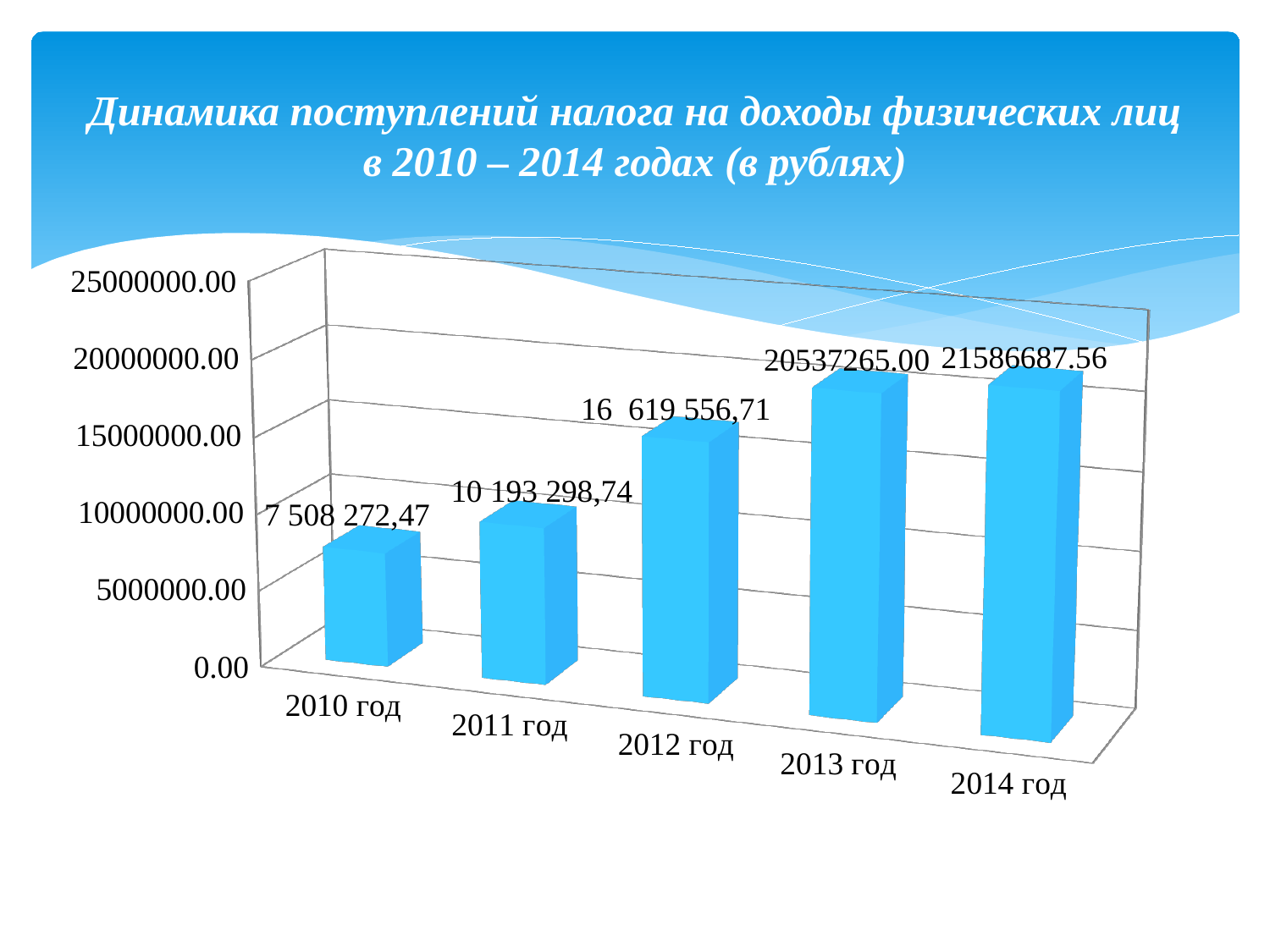
Do the values rise or fall from 2010 год to 2014 год? rise What is the value for 2014 год? 21586687.56 Is the value for 2010 год greater or less than 10000000.00? less What is the value for 2010 год? 7 508 272,47 What kind of chart is shown on the slide? bar chart How many years are shown on the chart? 5 What is the difference between the values for 2014 год and 2013 год? 1049422.56 Which year has the highest value? 2014 год What is the value for 2013 год? 20537265.00 Which year has the lowest value? 2010 год What is the value for 2012 год? 16 619 556,71 Which is larger, the value for 2011 год or 2012 год? 2012 год